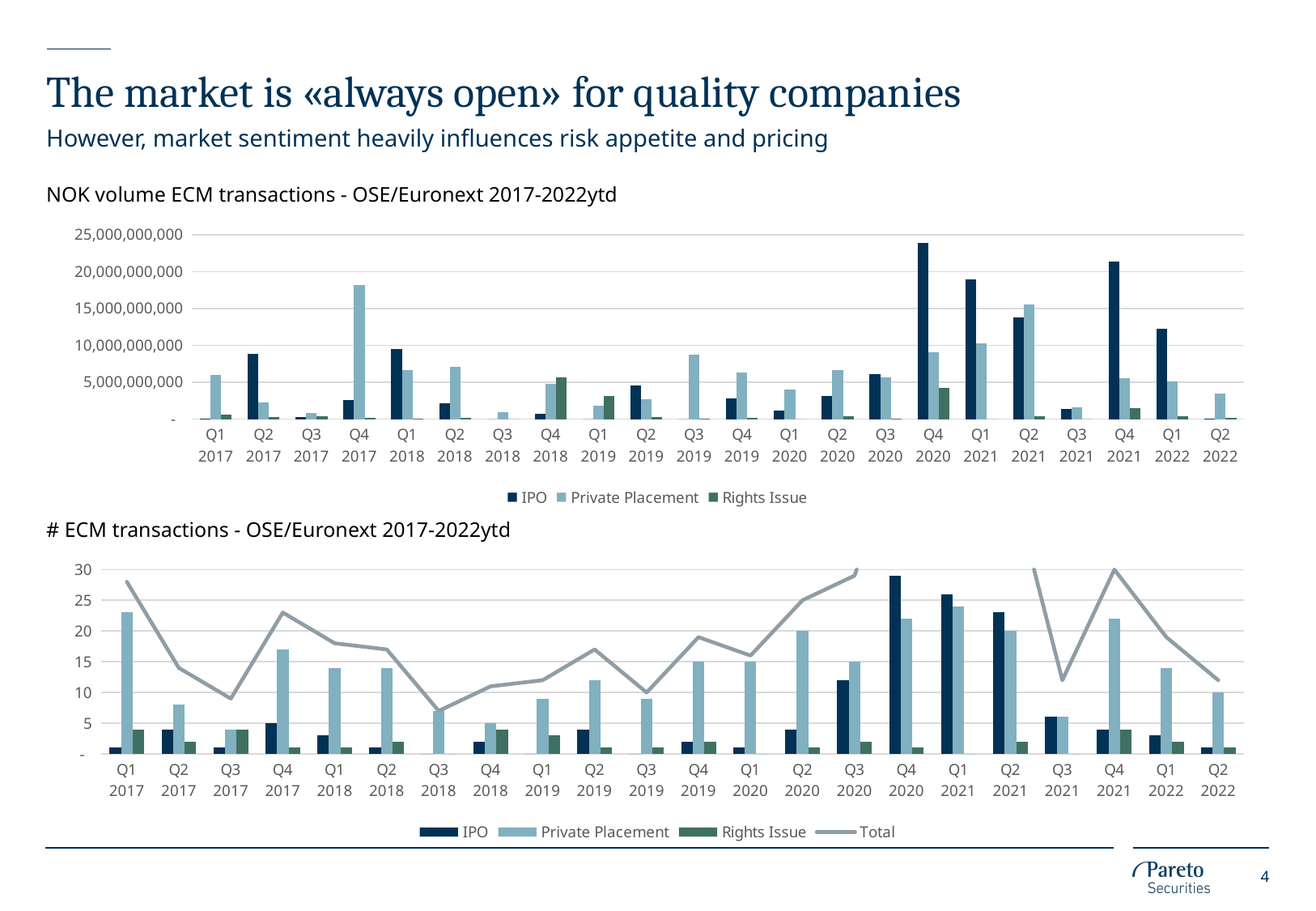
In the top chart (NOK volume ECM transactions), in which quarter is the IPO bar highest? Q4 2020 How many quarters are shown on the x axis of the bottom chart (# ECM transactions)? 22 In the top chart (NOK volume ECM transactions), which is larger: the IPO value for Q4 2020 or the IPO value for Q1 2021? Q4 2020 In the top chart (NOK volume ECM transactions), is the Private Placement value for Q4 2017 greater or less than 15,000,000,000? greater In the top chart (NOK volume ECM transactions), in which quarter is the Private Placement bar highest? Q4 2017 In the bottom chart (# ECM transactions), is the Total value for Q3 2021 greater or less than 15? less In the bottom chart (# ECM transactions), what is the Private Placement value for Q2 2022? 10 How many series does the legend of the top chart (NOK volume ECM transactions) list? 3 How many series does the legend of the bottom chart (# ECM transactions) list? 4 In the top chart (NOK volume ECM transactions), is the IPO value for Q4 2020 greater or less than 20,000,000,000? greater In the bottom chart (# ECM transactions), in which quarter is the IPO bar highest? Q4 2020 In the bottom chart (# ECM transactions), what is the Private Placement value for Q2 2020? 20